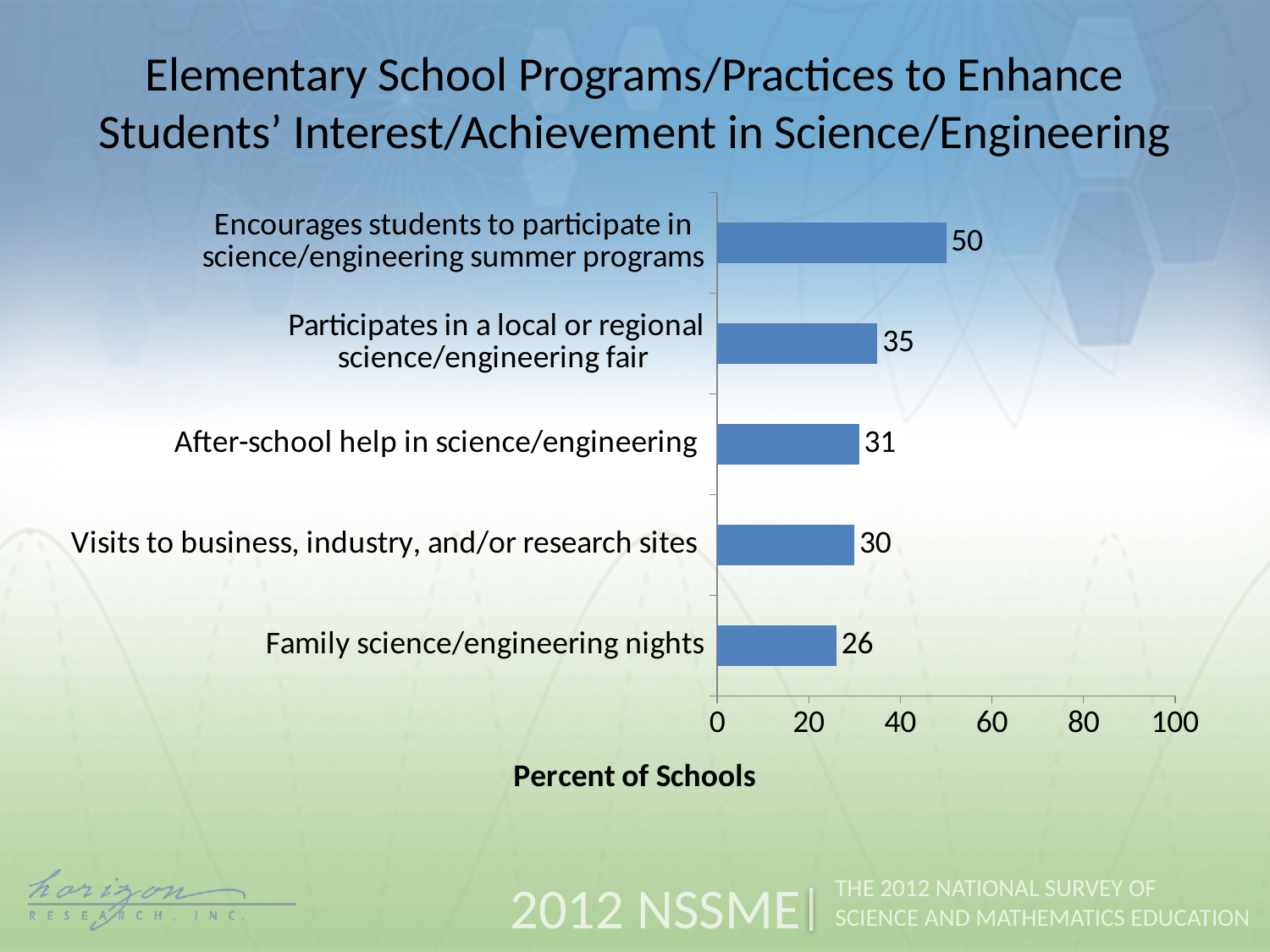
Which category has the highest value? Encourages students to participate in science/engineering summer programs What kind of chart is shown on the slide? bar chart What is the label of the horizontal axis? Percent of Schools Which is larger: the value for 'Participates in a local or regional science/engineering fair' or 'Family science/engineering nights'? Participates in a local or regional science/engineering fair What is the value for 'After-school help in science/engineering'? 31 How many categories are shown in the chart? 5 What is the value for 'Family science/engineering nights'? 26 Which category has the lowest value? Family science/engineering nights What is the difference between the values for 'Encourages students to participate in science/engineering summer programs' and 'Participates in a local or regional science/engineering fair'? 15 What is the value for 'Encourages students to participate in science/engineering summer programs'? 50 What is the difference between the values for 'Visits to business, industry, and/or research sites' and 'Family science/engineering nights'? 4 Is the value for 'Participates in a local or regional science/engineering fair' greater or less than 40? less